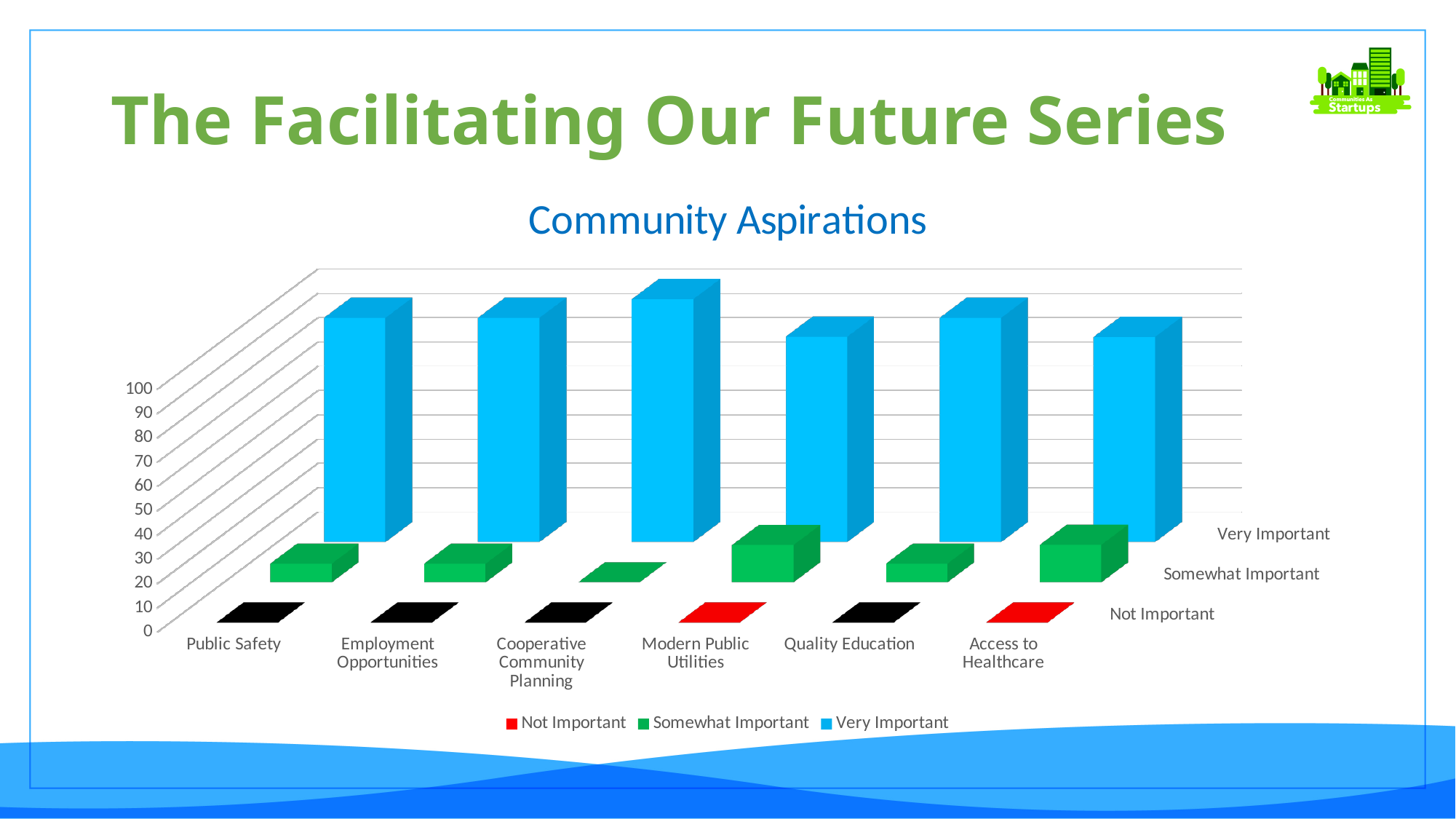
What colour represents the Very Important series? blue Is the Very Important value for Modern Public Utilities greater or less than 50? greater Is the Very Important value for Quality Education greater or less than 40? greater Which is larger for Modern Public Utilities: the Very Important value or the Quality Education Very Important value? Quality Education For Public Safety, which series has the larger value: Very Important or Somewhat Important? Very Important Which category has the lowest Somewhat Important value? Cooperative Community Planning What is the title of the chart? Community Aspirations How many categories are shown on the x axis? 6 Which category has the highest Very Important value? Cooperative Community Planning What type of chart is shown on the slide? bar chart How many series does the legend list? 3 Is the Somewhat Important value for Public Safety greater or less than 50? less